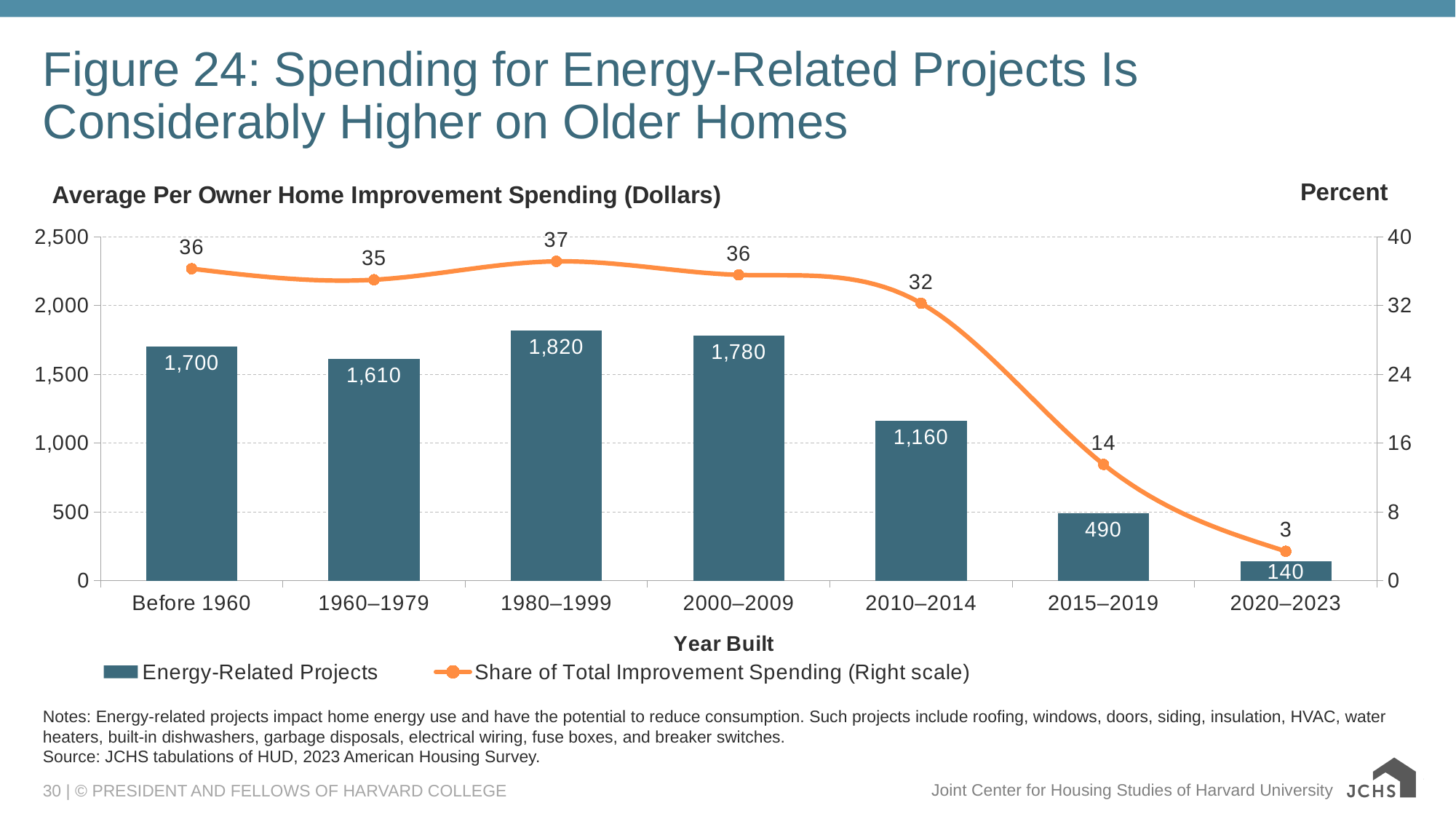
What kind of chart is used to show energy-related project spending? Bar chart What is the average per owner spending on energy-related projects for homes built 1980–1999? 1,820 What colour is the line for Share of Total Improvement Spending? Orange Which year-built category has the highest average spending on energy-related projects? 1980–1999 Does the share of total improvement spending rise or fall from 2010–2014 to 2020–2023? Fall How many year-built categories are shown on the x axis? 7 Which year-built category has the lowest share of total improvement spending? 2020–2023 What is the difference in energy-related project spending between homes built before 1960 and homes built 1960–1979? 90 Which has higher energy-related project spending: homes built 2000–2009 or homes built 2010–2014? 2000–2009 How many series does the legend list? 2 What is the label of the x axis? Year Built What is the share of total improvement spending for homes built 2015–2019? 14